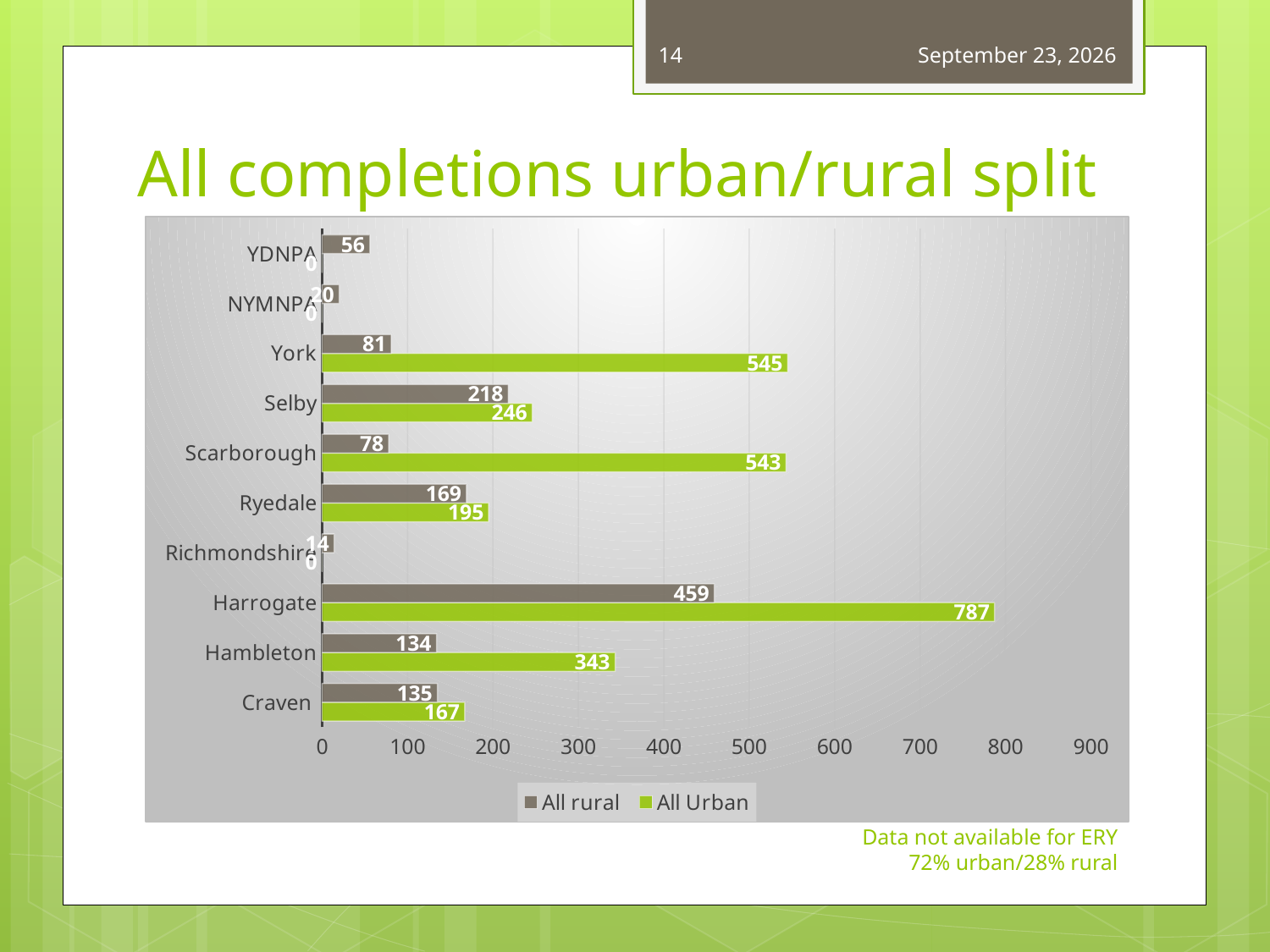
Which category has the highest All Urban value? Harrogate What kind of chart is shown on the slide? bar chart How many categories are shown on the chart? 10 For Selby, which is larger: All rural or All Urban? All Urban What is the difference between the All Urban and All rural values for Harrogate? 328 What is the All Urban value for Hambleton? 343 What is the All Urban value for Harrogate? 787 What is the difference between the All Urban and All rural values for Craven? 32 How many series does the legend list? 2 Is the All Urban value for Scarborough greater or less than 500? greater What is the All rural value for York? 81 Which category has the highest All rural value? Harrogate